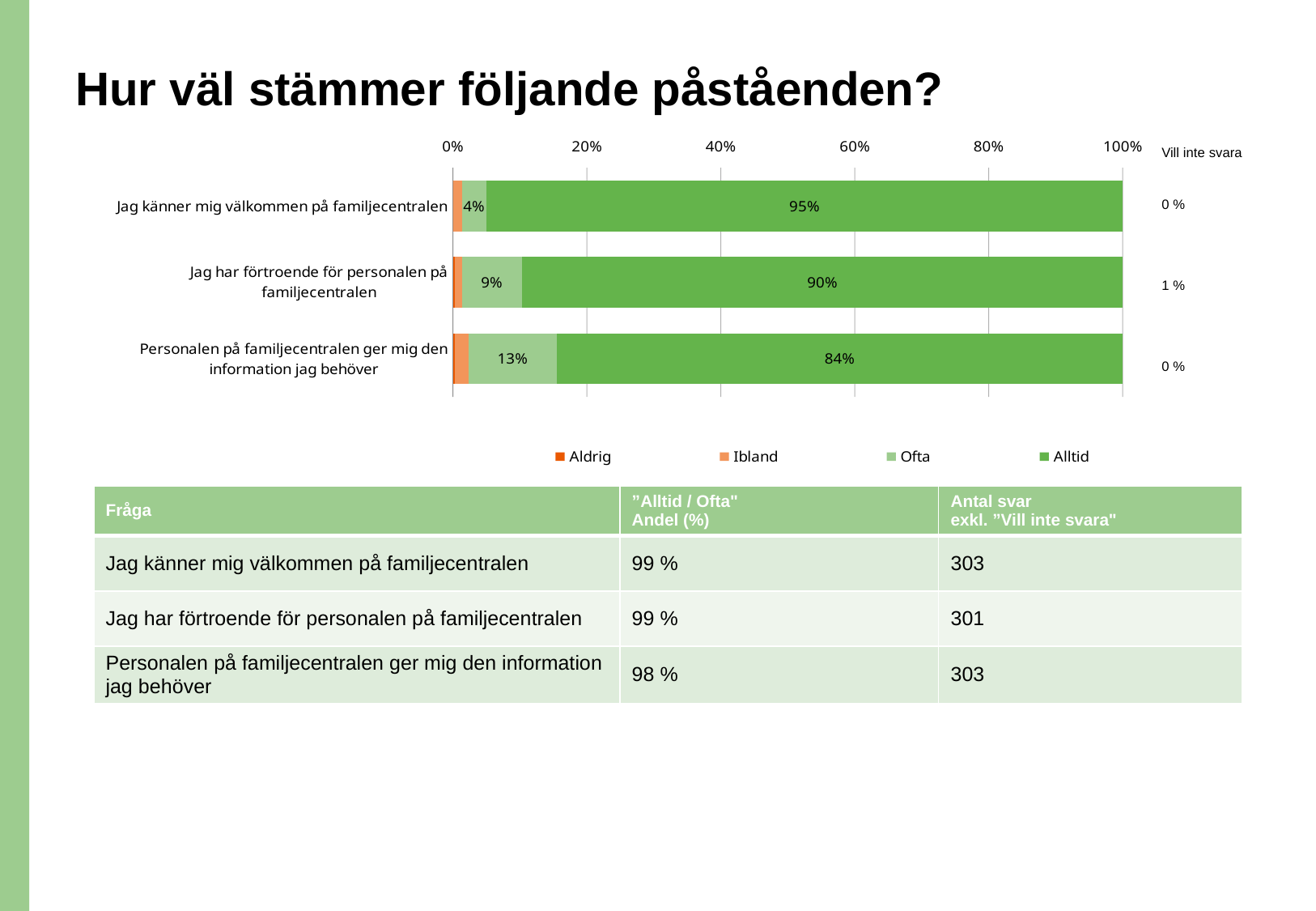
What is the "Ofta" value for "Personalen på familjecentralen ger mig den information jag behöver"? 13% How many series does the chart legend list? 4 What type of chart is shown on the slide? Stacked bar chart What is the "Alltid" value for "Personalen på familjecentralen ger mig den information jag behöver"? 84% What is the "Alltid" value for "Jag känner mig välkommen på familjecentralen"? 95% What is the difference between the "Alltid" values for "Jag har förtroende för personalen på familjecentralen" and "Personalen på familjecentralen ger mig den information jag behöver"? 6% How many statements (categories) are plotted in the chart? 3 What is the "Ofta" value for "Jag har förtroende för personalen på familjecentralen"? 9% Is the "Ofta" value for "Jag har förtroende för personalen på familjecentralen" larger or smaller than the "Ofta" value for "Personalen på familjecentralen ger mig den information jag behöver"? Smaller Which legend entry is shown in the darkest green colour? Alltid Which statement has the lowest "Alltid" value? Personalen på familjecentralen ger mig den information jag behöver Which statement has the highest "Alltid" value? Jag känner mig välkommen på familjecentralen